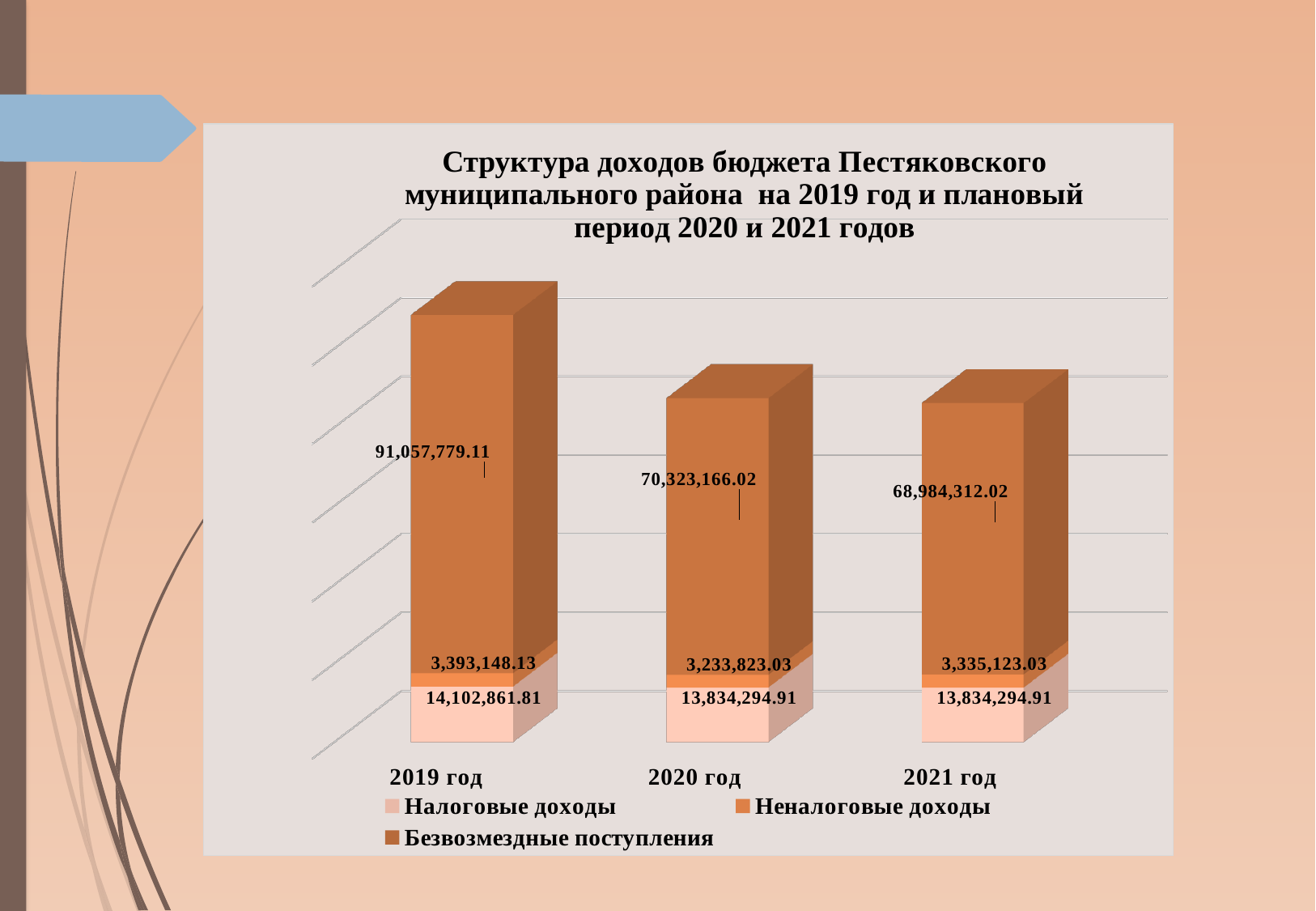
In which year is Неналоговые доходы the lowest? 2020 год In which year is Безвозмездные поступления the highest? 2019 год How many series does the legend list? 3 What is the value of Неналоговые доходы for 2021 год? 3,335,123.03 How many years are shown on the x axis? 3 What is the difference between Безвозмездные поступления in 2019 год and 2020 год? 20,734,613.09 Which is larger: Неналоговые доходы in 2019 год or in 2021 год? 2019 год What kind of chart is shown? Stacked bar chart What is the value of Безвозмездные поступления for 2019 год? 91,057,779.11 What is the difference between Налоговые доходы in 2019 год and 2021 год? 268,566.90 What is the total of the stacked bar for 2020 год? 87,391,283.96 What is the value of Налоговые доходы for 2020 год? 13,834,294.91